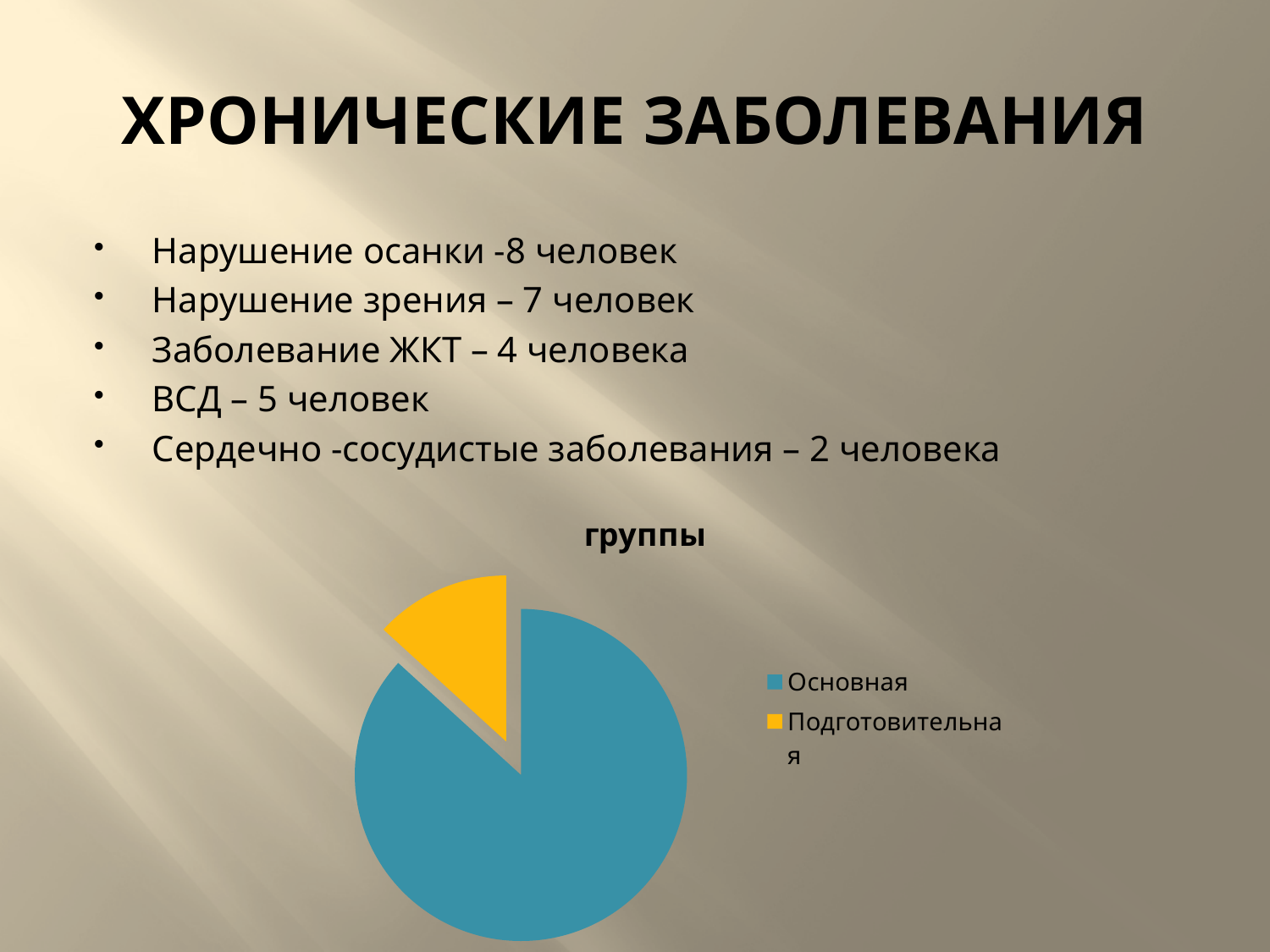
What kind of chart is shown on the slide? pie chart Which group has the largest slice of the pie? Основная Which slice is larger, Основная or Подготовительная? Основная Which group has the smallest slice of the pie? Подготовительная How many entries does the chart legend list? 2 What colour is the slice for Подготовительная? yellow What is the title of the chart? группы Is the share of Основная greater or less than 50% of the pie? greater Is the share of Подготовительная greater or less than 25% of the pie? less How many slices does the pie chart have? 2